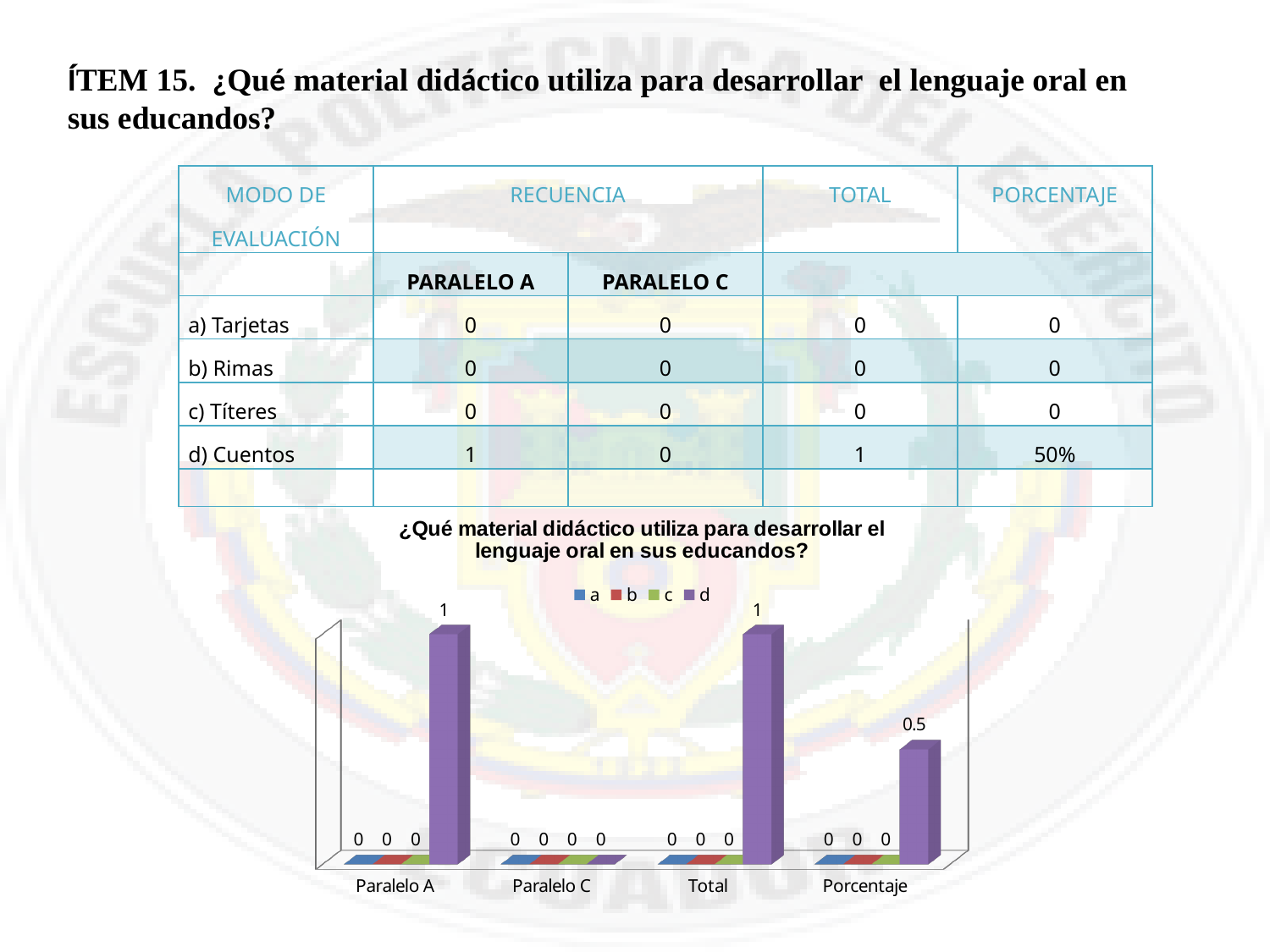
What type of chart is shown on the slide? bar chart What is the value of series d for Paralelo C? 0 What is the value of series d for Paralelo A? 1 What is the value of series d for Porcentaje? 0.5 Which is larger: the value of series d for Total or for Porcentaje? Total Which category has the lowest value for series d? Paralelo C What is the title of the chart? ¿Qué material didáctico utiliza para desarrollar el lenguaje oral en sus educandos? Which series has the highest value in the Paralelo A category? d What is the difference between the value of series d for Paralelo A and for Porcentaje? 0.5 How many series does the chart legend list? 4 What is the value of series a for Total? 0 How many categories are shown along the x axis of the chart? 4